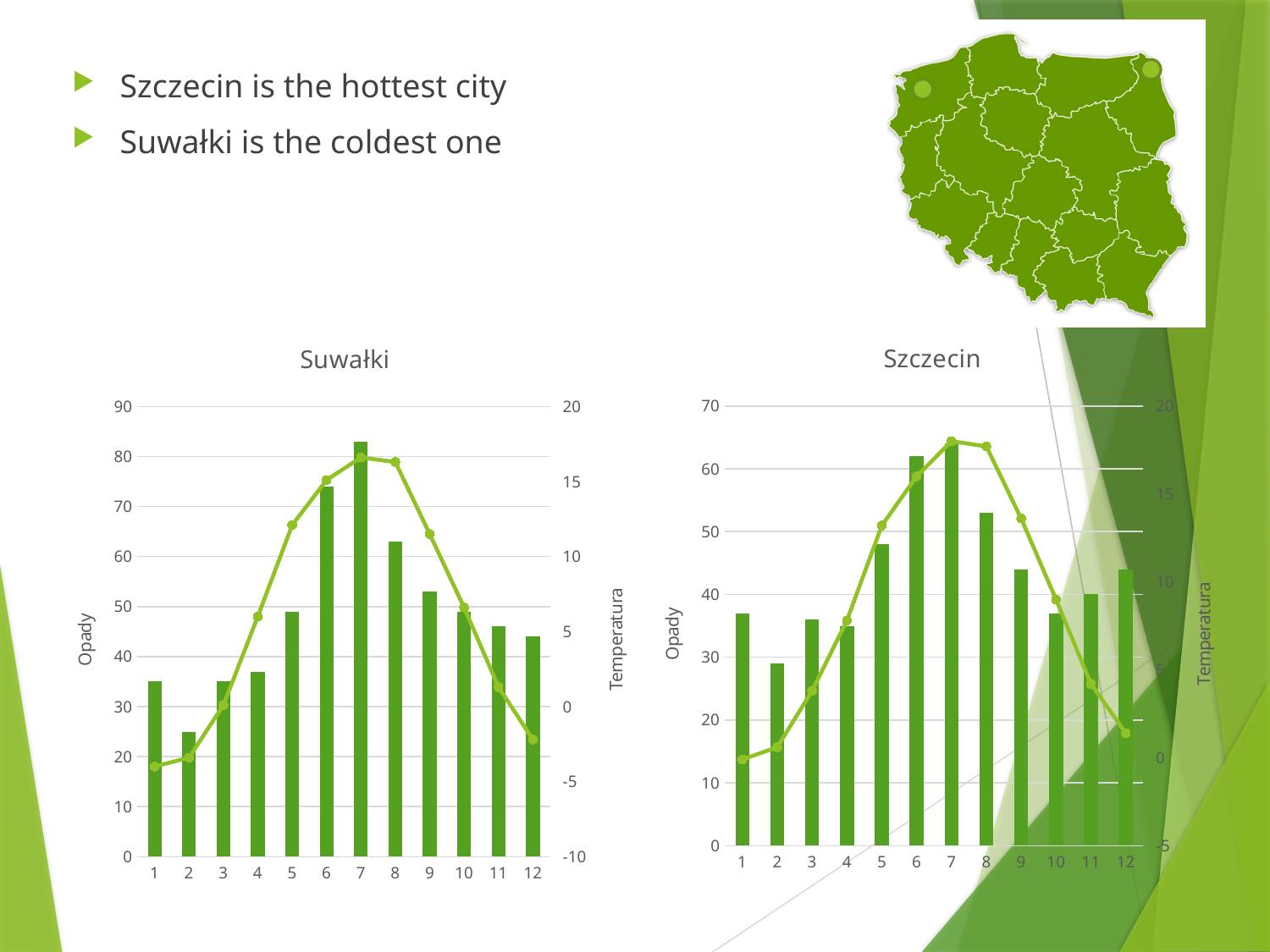
In the Szczecin chart, is the bar value for month 6 greater or less than 50? greater What kind of chart is the Suwałki chart? Combined bar and line chart How many months are shown on the x axis of the Szczecin chart? 12 In the Suwałki chart, does the temperature line rise or fall from month 1 to month 7? Rise In the Szczecin chart, which month has the shortest bar? 2 In the Suwałki chart, is the bar value for month 7 greater or less than 70? greater In the Suwałki chart, which month has the shortest bar? 2 What is the title of the left vertical axis in the Szczecin chart? Opady In the Suwałki chart, which month has the tallest bar? 7 In the Szczecin chart, is the bar value for month 2 greater or less than 40? less In the Suwałki chart, which month has the highest point on the temperature line? 7